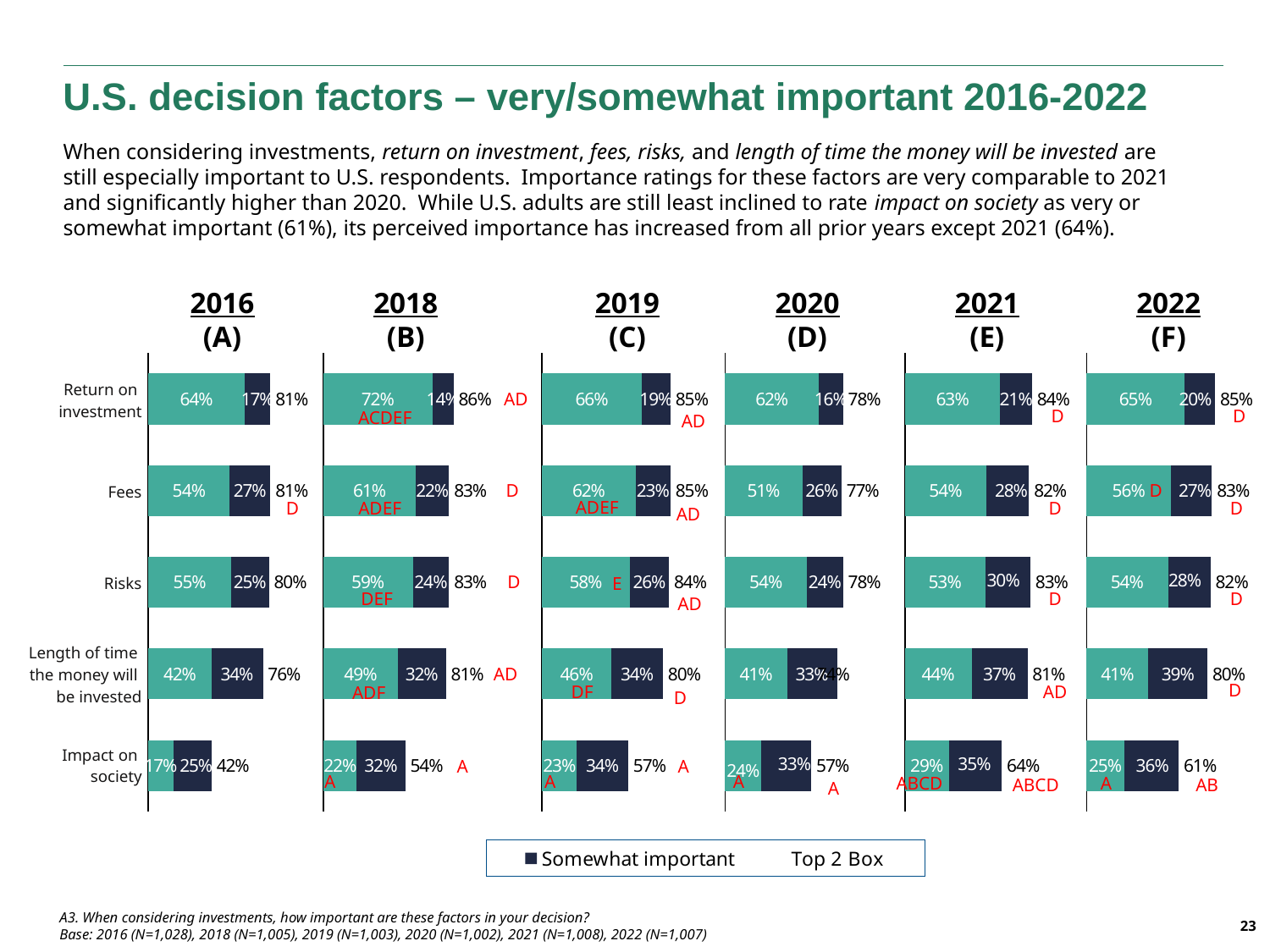
How many separate charts (years) are shown on the slide? 6 How many factors (categories) are shown in each chart? 5 How many entries does the legend at the bottom of the slide list? 2 In the 2022 (F) chart, what is the total of the 41% and 39% segments for Length of time the money will be invested? 80% In the 2018 (B) chart, which factor has the highest Top 2 Box value? Return on investment In the 2018 (B) chart, what is the teal (left segment) value for Return on investment? 72% In the 2022 (F) chart, what is the Top 2 Box value for Impact on society? 61% In the 2019 (C) chart, what is the difference between the Top 2 Box values for Return on investment and Impact on society? 28% In the 2021 (E) chart, what is the Somewhat important value for Length of time the money will be invested? 37% What type of chart is used to show the decision factors on this slide? Stacked bar chart In the 2016 (A) chart, which factor has the lowest Top 2 Box value? Impact on society In the 2020 (D) chart, which is larger: the Top 2 Box value for Fees or for Risks? Risks